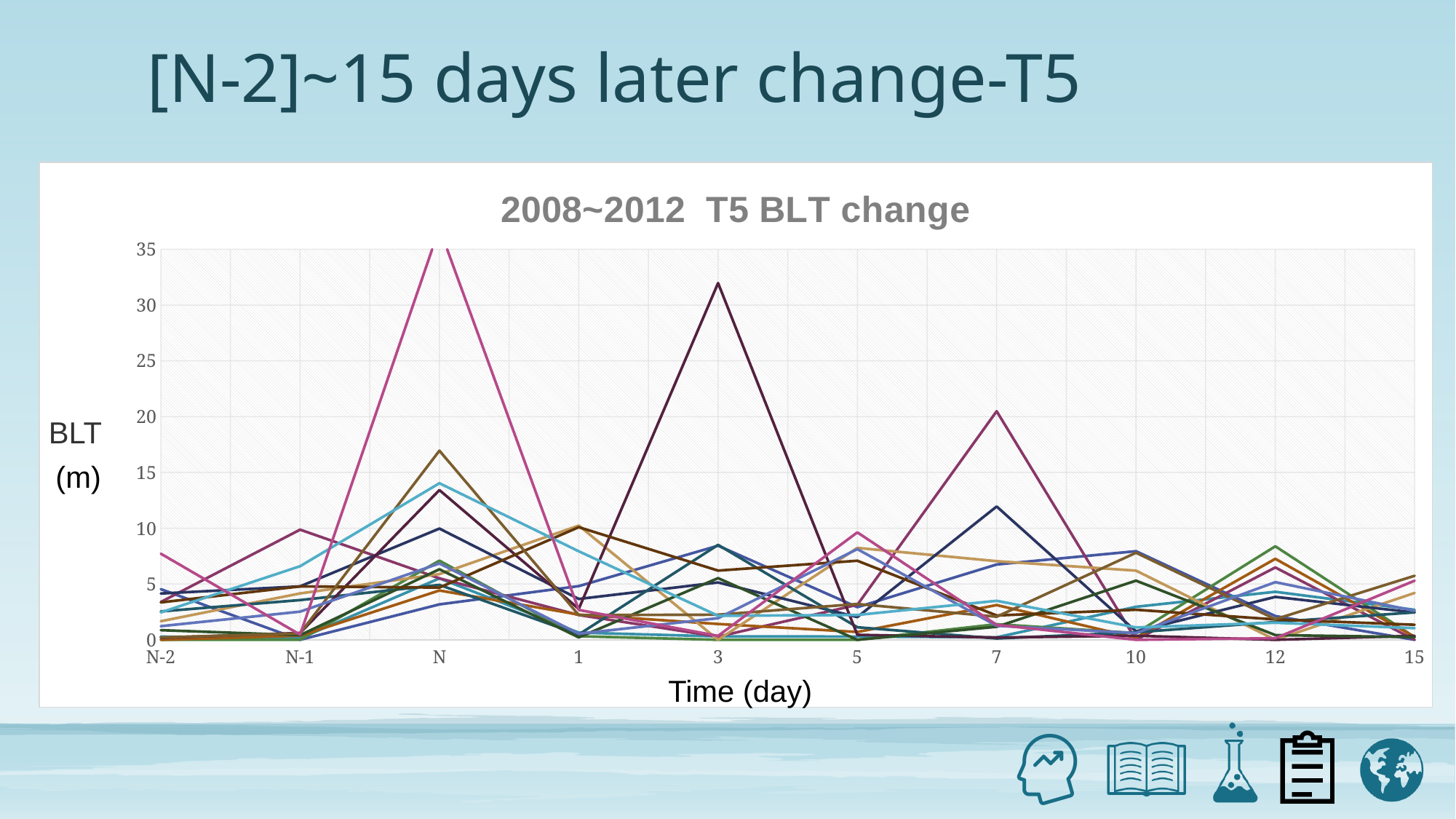
What is the title of the chart? 2008~2012 T5 BLT change At which x-axis point does the highest value of any line occur? N What is the highest tick value shown on the y axis? 35 Is the highest value reached at day 7 greater or less than 15? greater Is the highest value reached at day 15 greater or less than 10? less Is the highest value reached at day 3 greater or less than 30? greater What is the label of the x axis? Time (day) How many points are labelled along the x axis of the chart? 10 What kind of chart is shown on the slide? line chart Which x-axis point has a higher peak value, day 3 or day 7? day 3